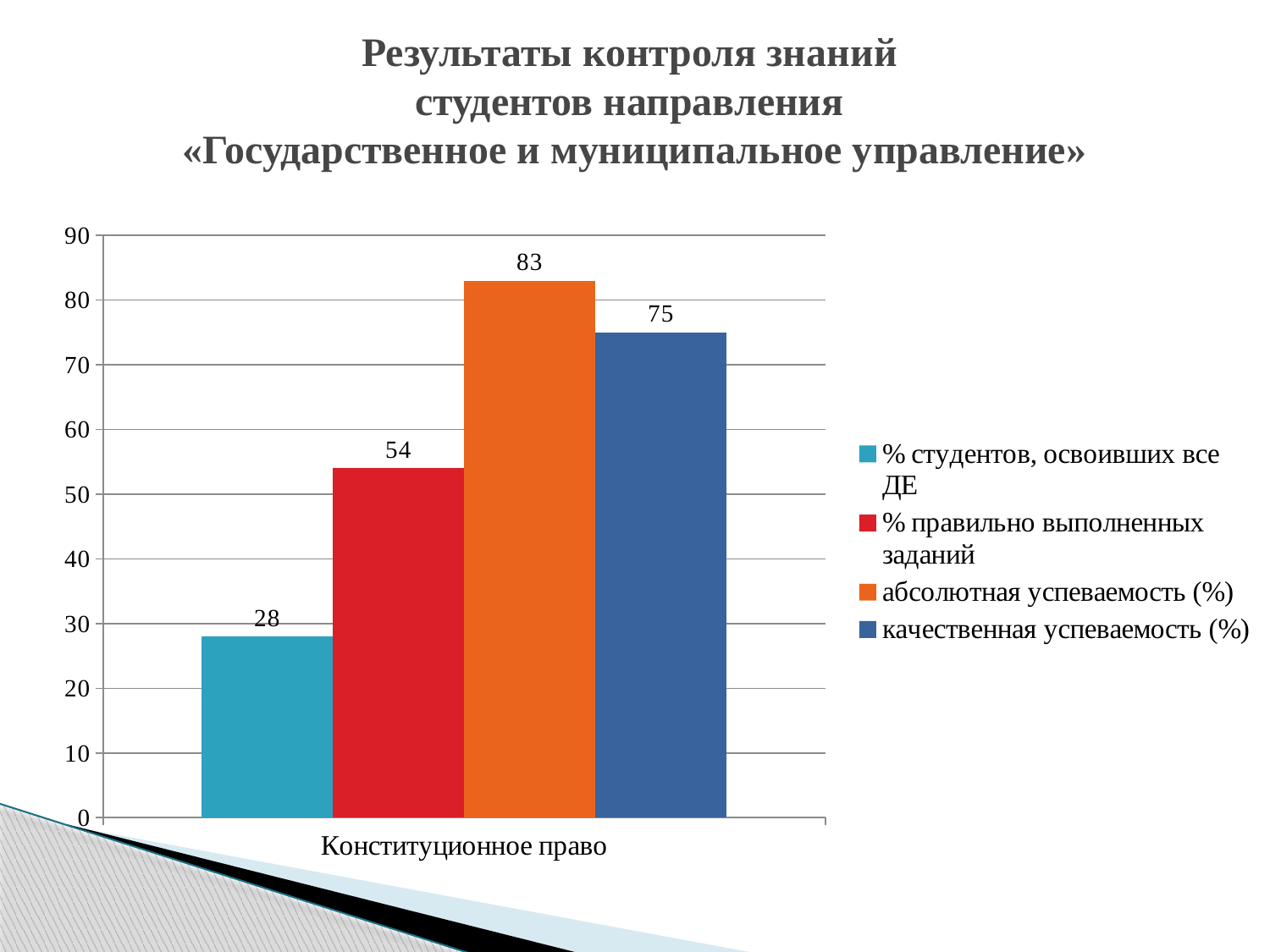
Which series has the lowest value for Конституционное право? % студентов, освоивших все ДЕ Which is larger: «% правильно выполненных заданий» or «качественная успеваемость (%)»? качественная успеваемость (%) What is the difference between «абсолютная успеваемость (%)» and «качественная успеваемость (%)» for Конституционное право? 8 How many series does the legend list? 4 What is the difference between «% правильно выполненных заданий» and «% студентов, освоивших все ДЕ»? 26 What is the value of «% студентов, освоивших все ДЕ» for Конституционное право? 28 What is the category label shown on the x axis? Конституционное право What is the value of «качественная успеваемость (%)» for Конституционное право? 75 Which series has the highest value for Конституционное право? абсолютная успеваемость (%) What is the value of «% правильно выполненных заданий» for Конституционное право? 54 What is the value of «абсолютная успеваемость (%)» for Конституционное право? 83 What kind of chart is shown on the slide? bar chart